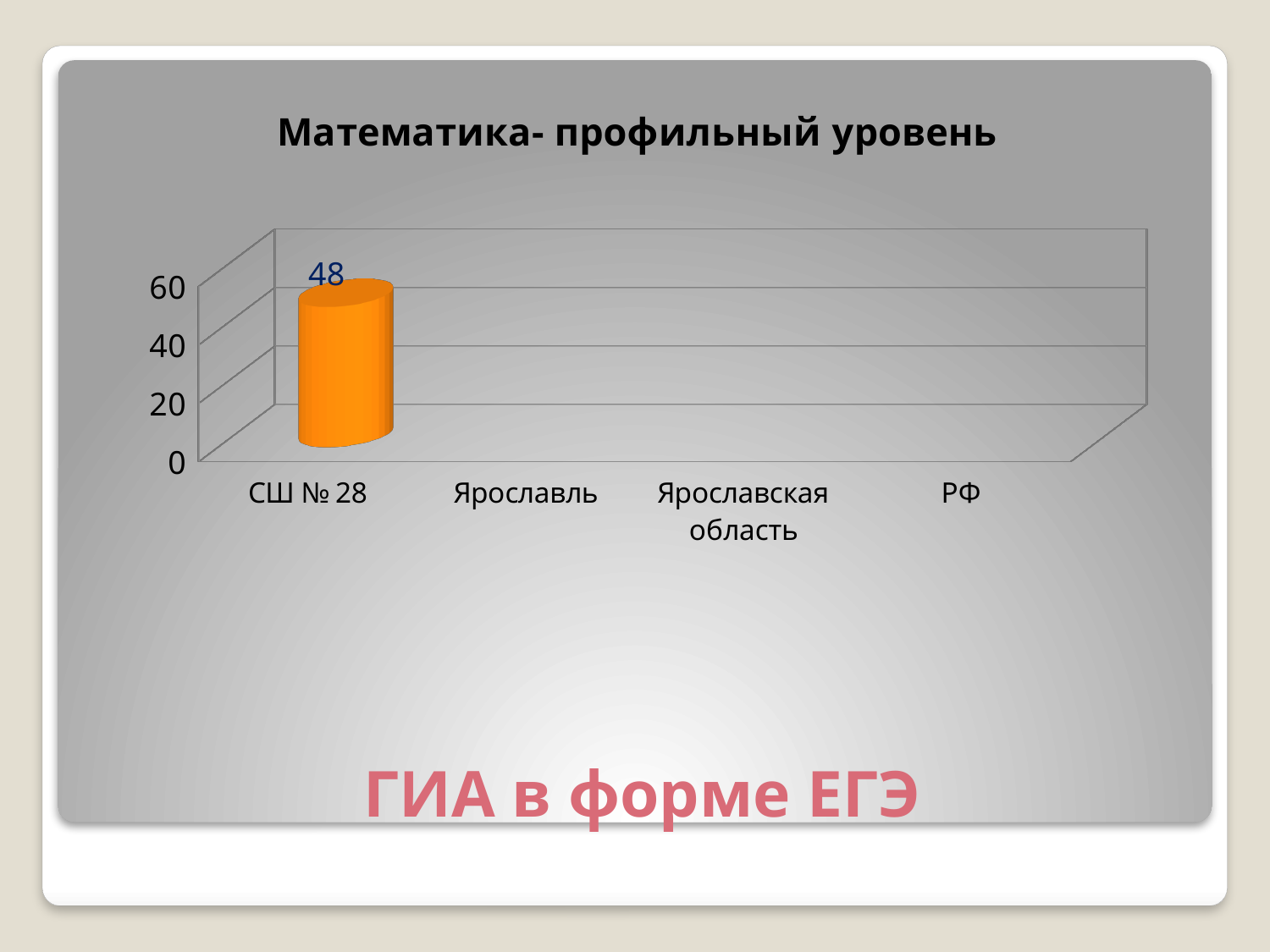
What is the title of the chart? Математика- профильный уровень Is the value for СШ № 28 greater or less than 60? less Which category is the only one with a plotted bar? СШ № 28 How many bars are plotted on the chart? 1 What is the highest value shown on the vertical axis? 60 What kind of chart is shown on the slide? bar chart How many categories are labelled on the x axis? 4 What is the value for СШ № 28? 48 Is the value for СШ № 28 greater or less than 40? greater